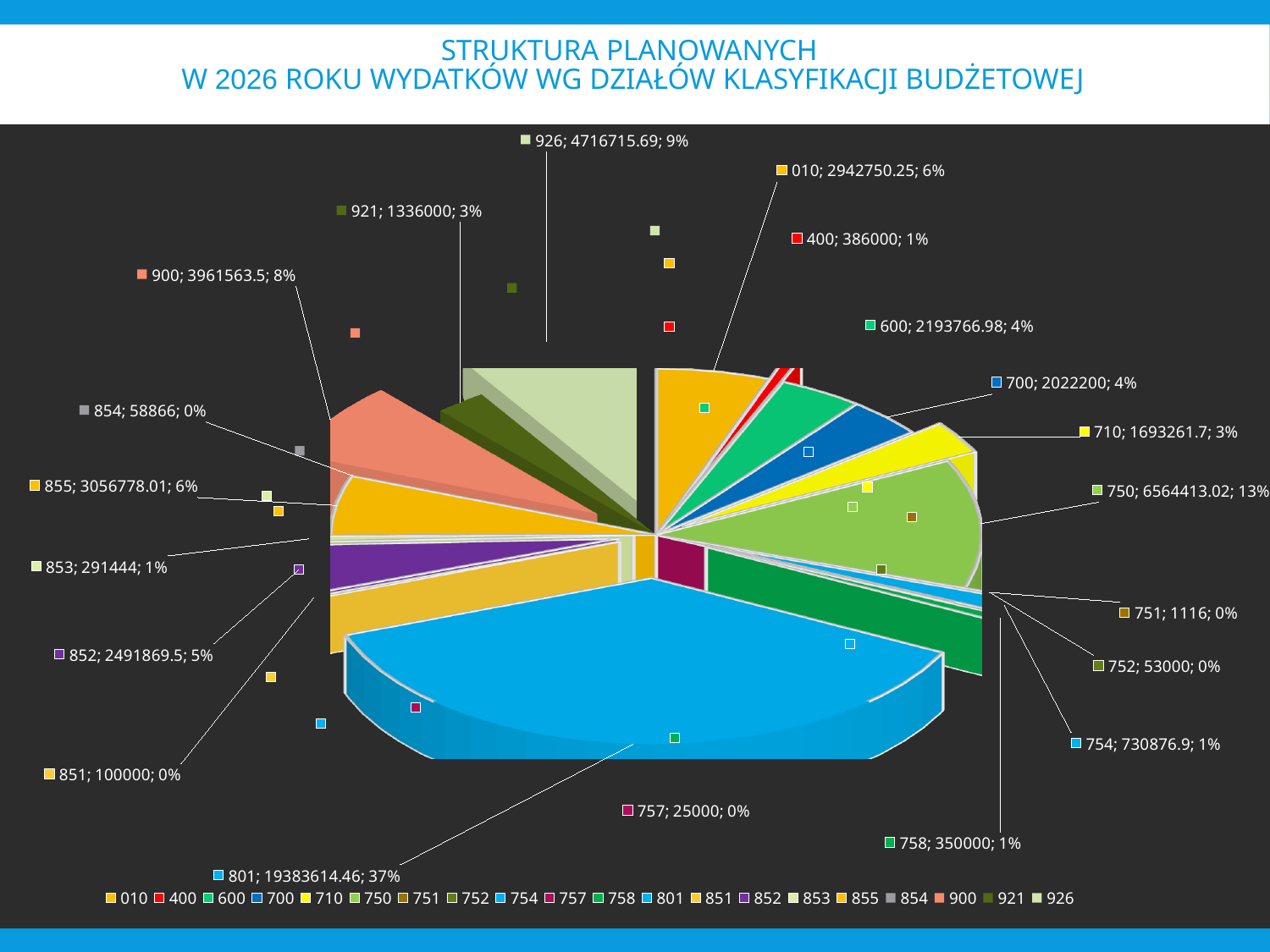
What type of chart is shown on the slide? pie chart Which category has the smallest value? 751 What share of the pie does category 926 represent? 9% What share of the pie does category 750 represent? 13% What is the value for category 754? 730876.9 What is the value for category 900? 3961563.5 Which is larger, the value for 010 or the value for 855? 855 What is the value for category 750? 6564413.02 What is the difference between the values for 752 and 757? 28000 What is the value for category 801? 19383614.46 Which category has the largest slice of the pie? 801 How many categories does the legend list? 20